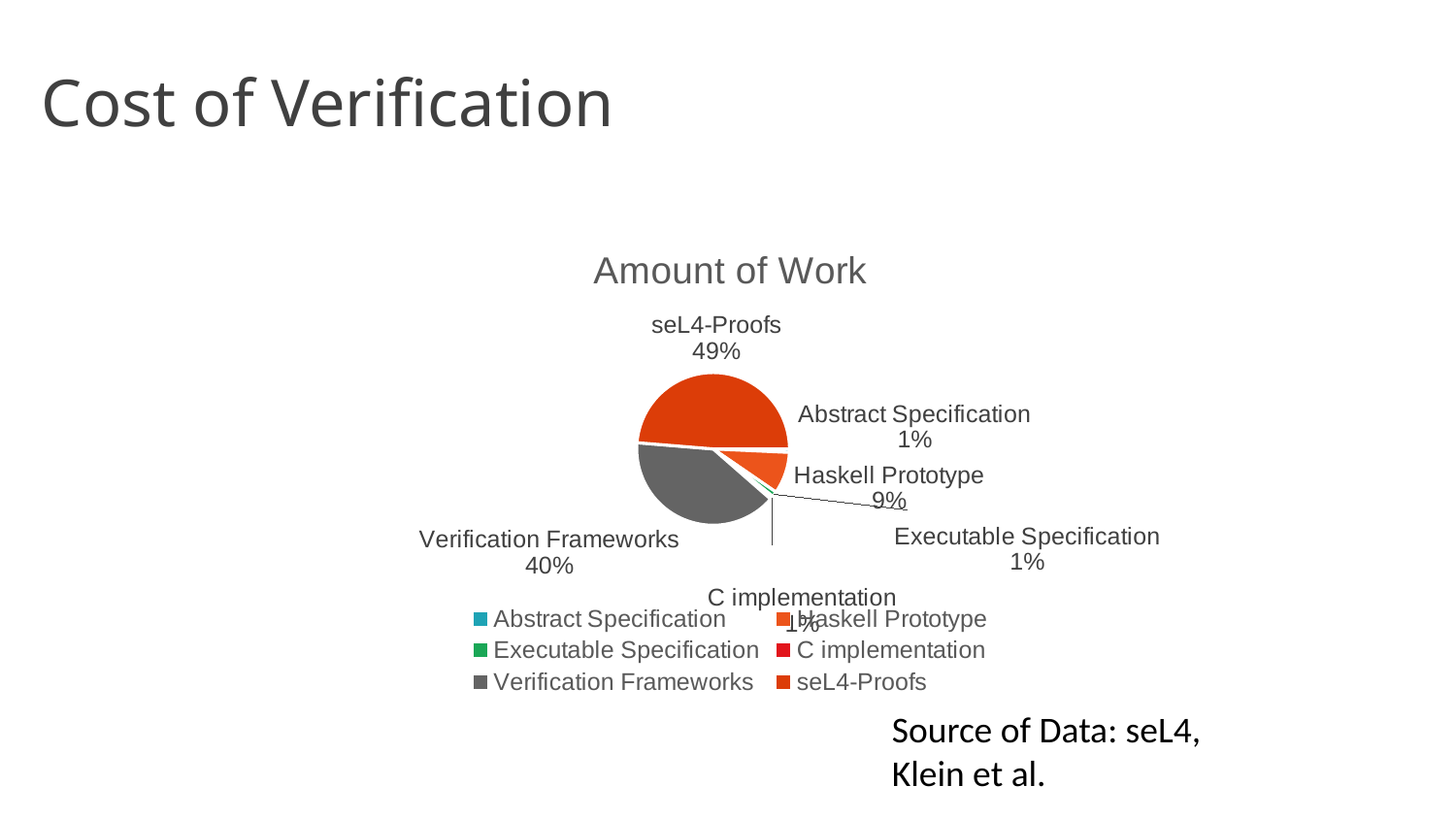
What kind of chart is shown on the slide? pie chart What share of the pie is Haskell Prototype? 9% What share of the pie is Executable Specification? 1% Which category has the largest slice of the pie? seL4-Proofs What is the difference in percentage points between seL4-Proofs and Verification Frameworks? 9 What share of the pie is Verification Frameworks? 40% How many slices does the pie chart have? 6 What is the title of the chart? Amount of Work How many categories does the legend list? 6 Which is larger, the slice for Verification Frameworks or the slice for Haskell Prototype? Verification Frameworks